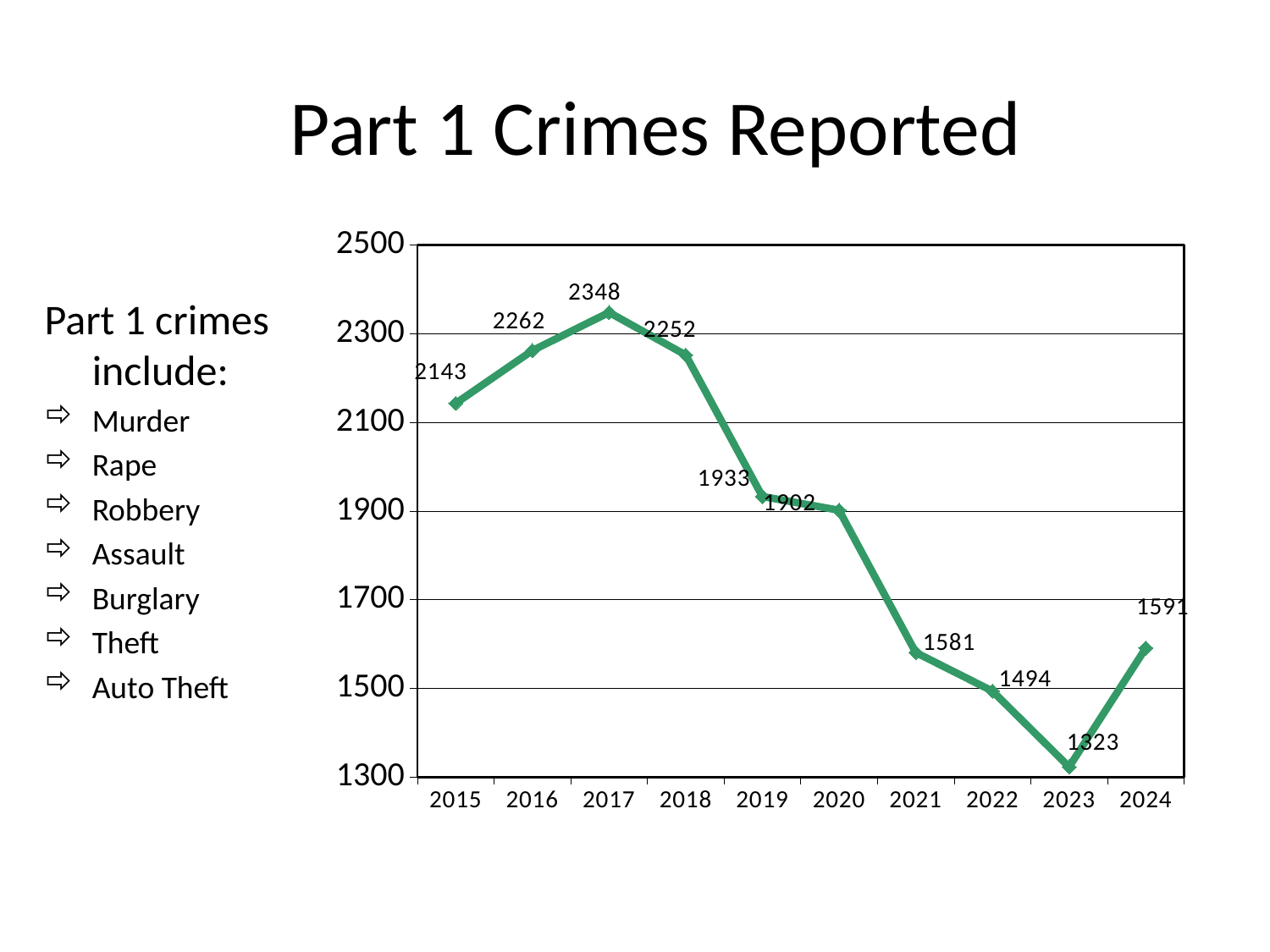
What is the overall trend of the values from 2017 to 2023? Falling What is the difference between the values for 2017 and 2023? 1025 Which year has a larger value, 2016 or 2018? 2016 By how much did the value change from 2023 to 2024? 268 How many years are plotted on the x axis? 10 How many Part 1 crimes were reported in 2017? 2348 Which year has the highest number of Part 1 crimes reported? 2017 What is the value plotted for 2020? 1902 What type of chart is shown on the slide? Line chart Which year has the lowest number of Part 1 crimes reported? 2023 How many Part 1 crimes were reported in 2023? 1323 Is the value for 2021 greater or less than 1700? less